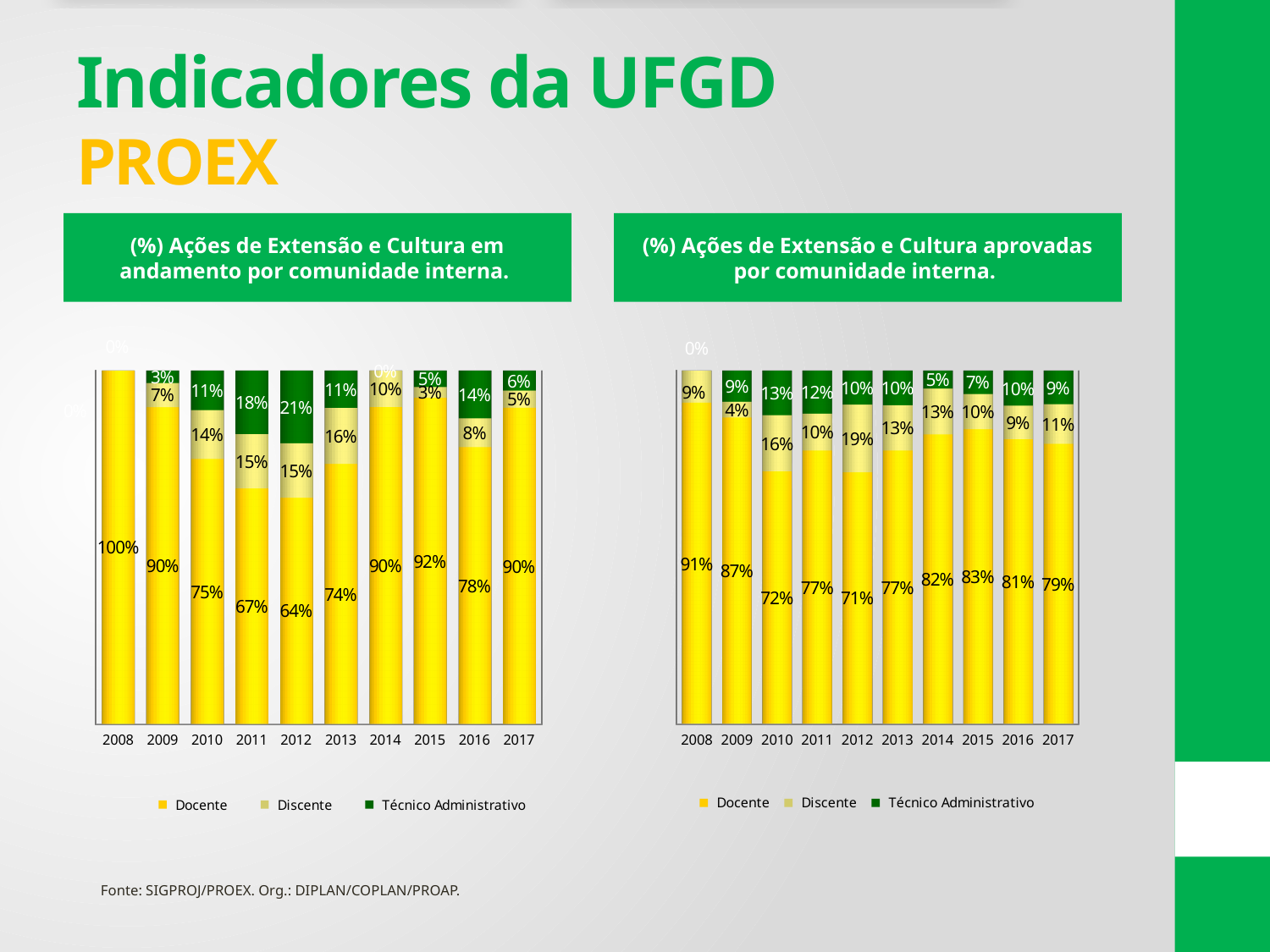
In the left chart (Ações de Extensão e Cultura em andamento), which year has the lowest Docente share? 2012 In the right chart (Ações de Extensão e Cultura aprovadas), what is the Docente value for 2015? 83% How many series does the legend of the left chart (Ações de Extensão e Cultura em andamento) list? 3 In the left chart (Ações de Extensão e Cultura em andamento), what is the difference between the Docente values for 2008 and 2011? 33% In the right chart (Ações de Extensão e Cultura aprovadas), what is the Discente value for 2012? 19% In the right chart (Ações de Extensão e Cultura aprovadas), which year has the lowest Docente share? 2012 In the left chart (Ações de Extensão e Cultura em andamento), what is the Docente value for 2012? 64% In the left chart (Ações de Extensão e Cultura em andamento), what is the Técnico Administrativo value for 2011? 18% In the right chart (Ações de Extensão e Cultura aprovadas), is the Docente value for 2010 larger or smaller than the Docente value for 2014? smaller What type of chart is the right chart (Ações de Extensão e Cultura aprovadas)? Stacked bar chart How many years are shown on the x axis of the right chart (Ações de Extensão e Cultura aprovadas)? 10 In the left chart (Ações de Extensão e Cultura em andamento), which year has the highest Técnico Administrativo share? 2012